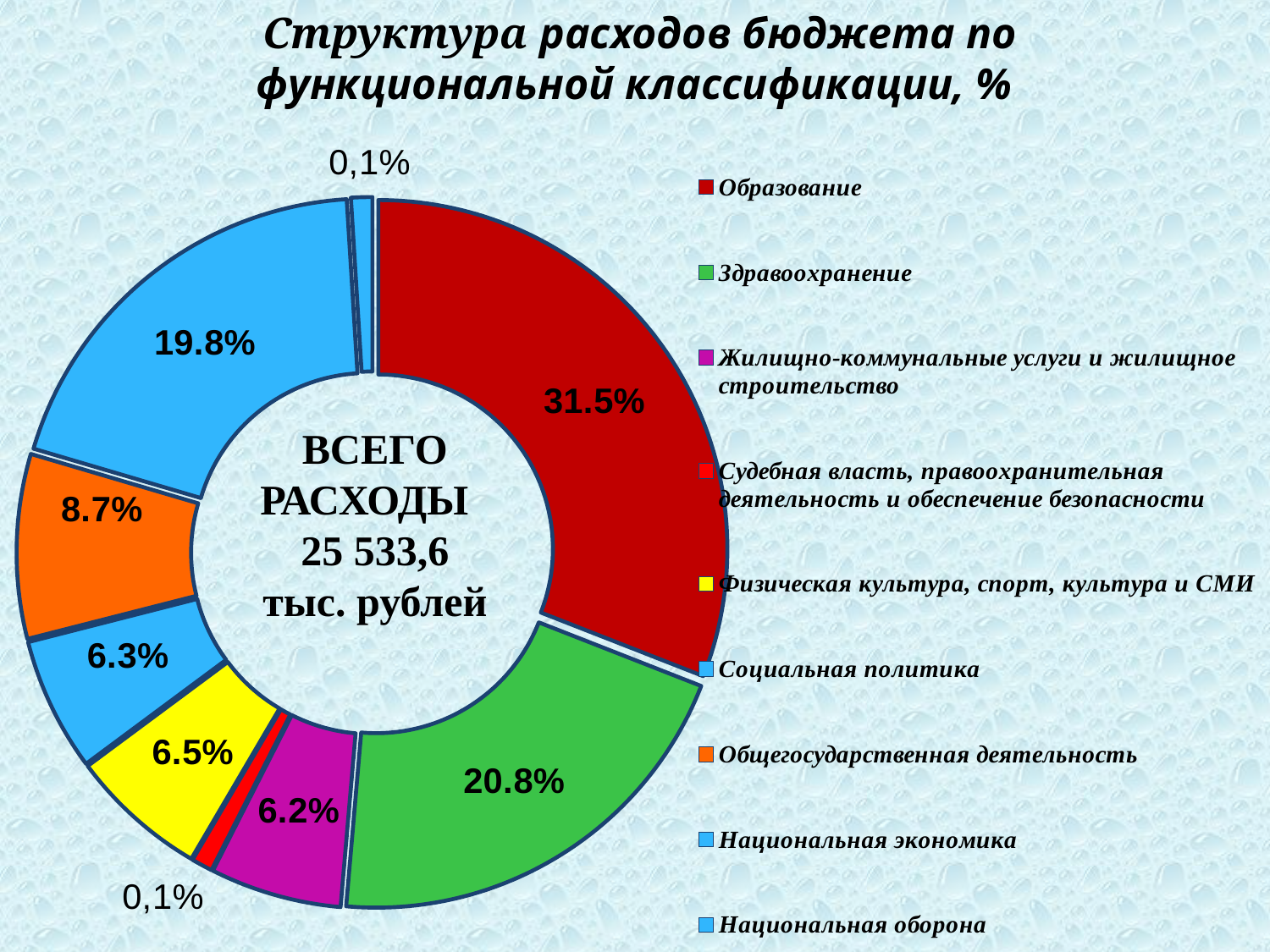
What share of budget expenditures goes to Здравоохранение? 20.8% Which category has the largest share of budget expenditures? Образование Which is larger: the share for Физическая культура, спорт, культура и СМИ or the share for Социальная политика? Физическая культура, спорт, культура и СМИ What colour represents Образование in the chart? Dark red What is the total expenditure amount shown in the centre of the chart? 25 533,6 тыс. рублей How many categories does the legend list? 9 What type of chart is shown on the slide? Doughnut (pie) chart What share of budget expenditures goes to Жилищно-коммунальные услуги и жилищное строительство? 6.2% What share of budget expenditures goes to Образование? 31.5% What share of budget expenditures goes to Общегосударственная деятельность? 8.7% What is the difference in percentage points between Образование and Здравоохранение? 10.7 What share of budget expenditures goes to Национальная экономика? 19.8%